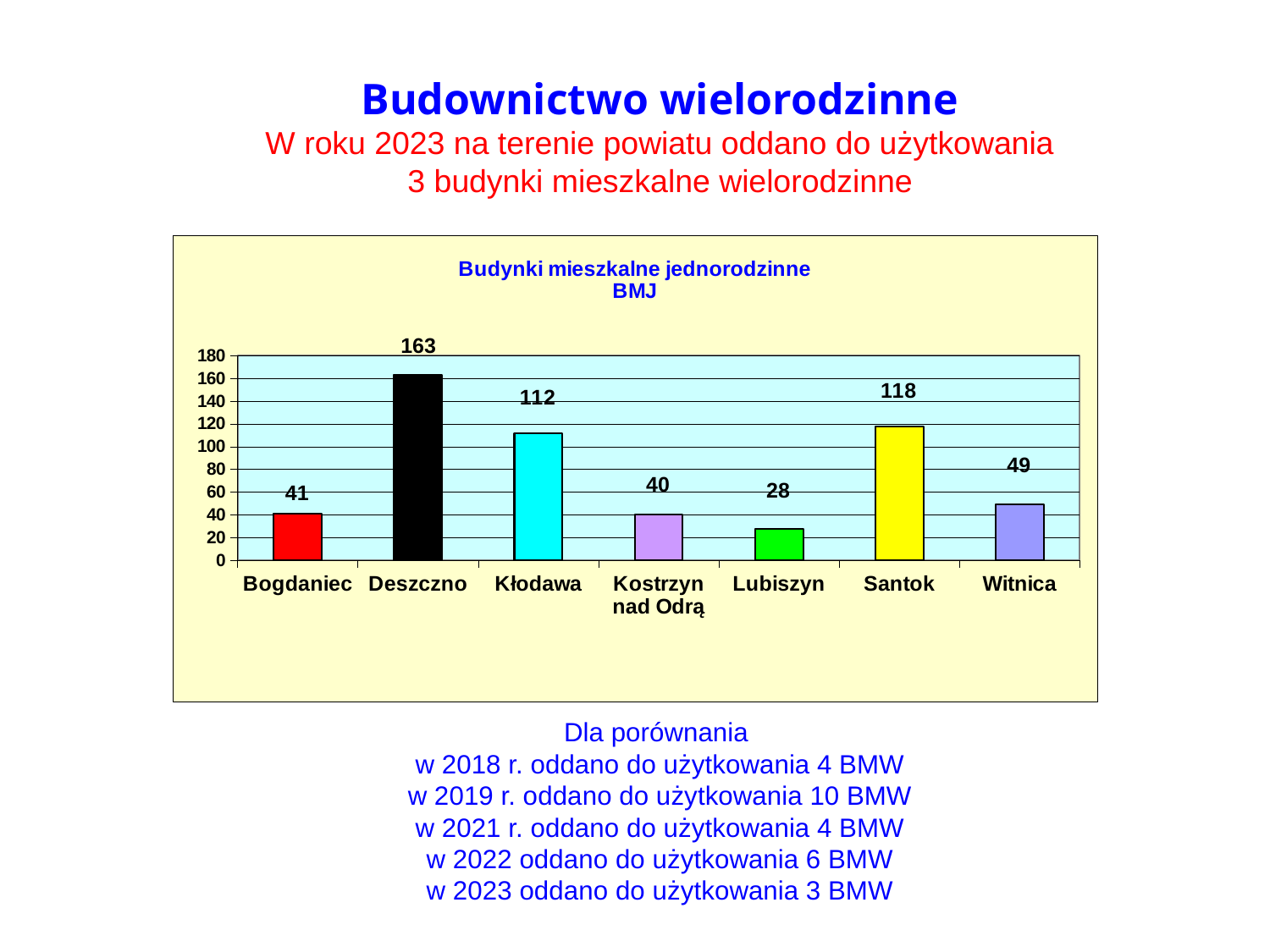
What is the title of the chart? Budynki mieszkalne jednorodzinne BMJ What is the value for Kostrzyn nad Odrą? 40 What is the value for Witnica? 49 Which category has the lowest value? Lubiszyn Which category has the highest value? Deszczno What is the value for Deszczno? 163 How many categories are shown on the x axis? 7 What is the difference between the values for Bogdaniec and Lubiszyn? 13 What kind of chart is shown on the slide? bar chart Which is larger, the value for Kłodawa or the value for Santok? Santok Is the value for Kłodawa greater or less than 100? greater What is the difference between the values for Deszczno and Santok? 45